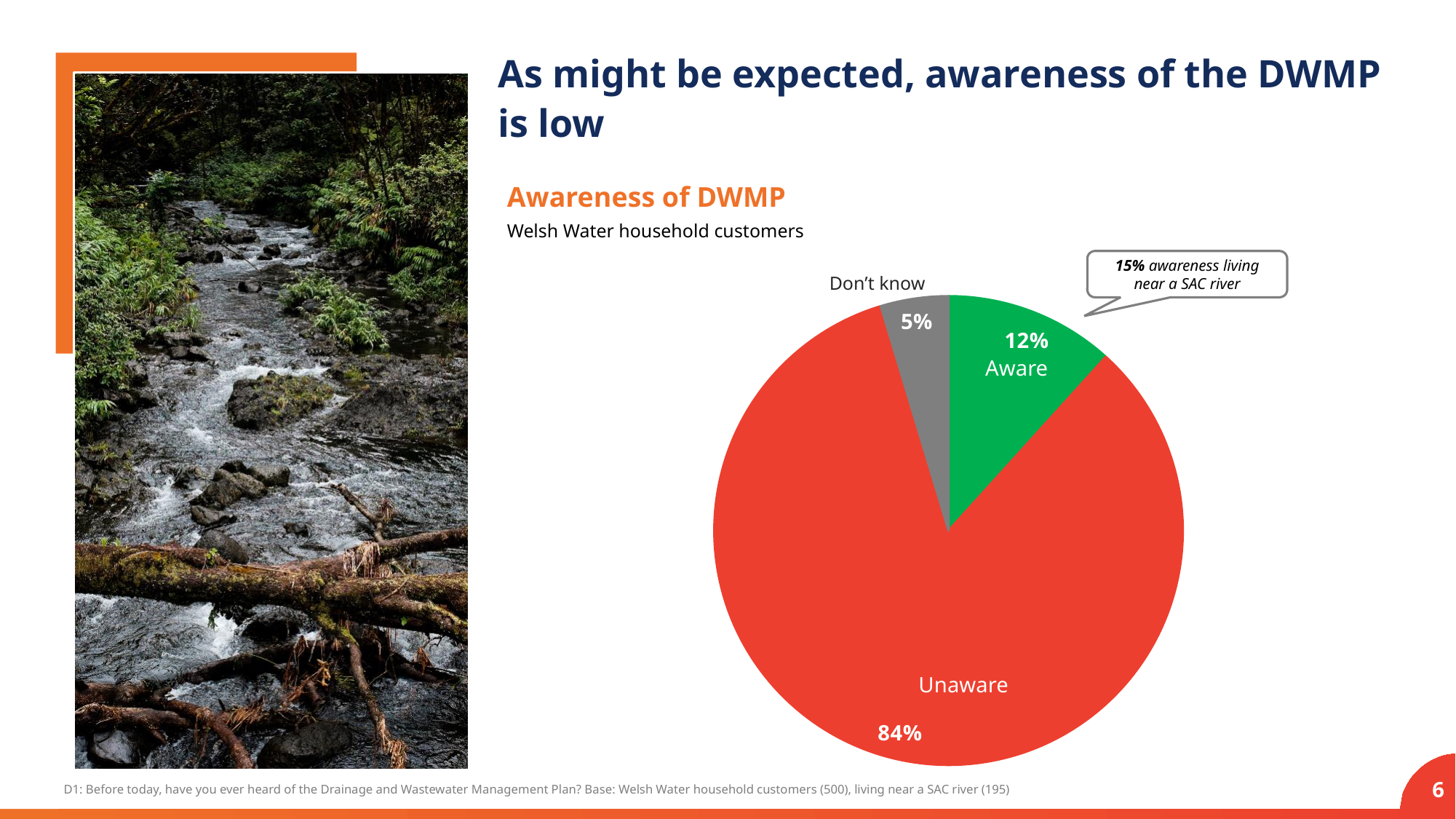
What is the title of the chart? Awareness of DWMP What kind of chart is shown on the slide? Pie chart According to the callout, what is the awareness level among those living near a SAC river? 15% Which is larger, the Aware share or the Don't know share? Aware What percentage of respondents answered Don't know? 5% Which category has the smallest share of the pie? Don't know What is the difference in percentage points between Unaware and Aware? 72 Which category has the largest share of the pie? Unaware How many slices does the pie chart have? 3 What percentage of Welsh Water household customers are Unaware of the DWMP? 84% What percentage of Welsh Water household customers are Aware of the DWMP? 12% What colour is the Unaware slice? Red